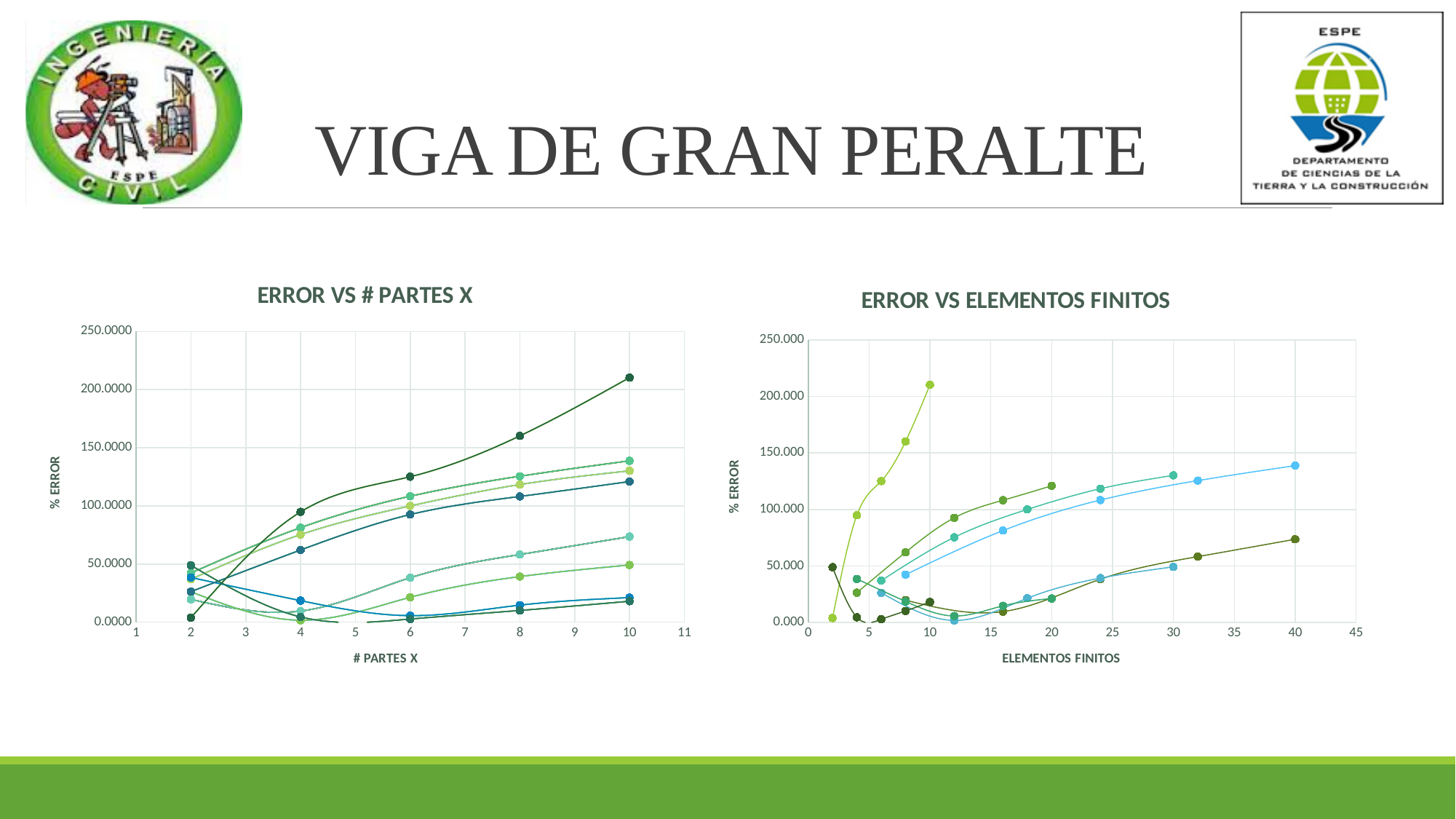
In the ERROR VS # PARTES X chart, is the highest plotted value greater or less than 200? greater What kind of chart is the ERROR VS # PARTES X chart? line chart In the ERROR VS # PARTES X chart, does the series that reaches the highest value at 10 partes rise or fall between 4 and 10 partes? rise How many charts are shown on the slide? 2 In the ERROR VS ELEMENTOS FINITOS chart, is the highest value plotted at 40 elementos finitos greater or less than 100? greater In the ERROR VS # PARTES X chart, is the lowest value plotted at 10 partes greater or less than 50? less In the ERROR VS ELEMENTOS FINITOS chart, does the series that reaches the highest value rise or fall between 2 and 10 elementos finitos? rise What kind of chart is the ERROR VS ELEMENTOS FINITOS chart? line chart What is the title of the chart on the left of the slide? ERROR VS # PARTES X What is the x-axis label of the ERROR VS ELEMENTOS FINITOS chart? ELEMENTOS FINITOS